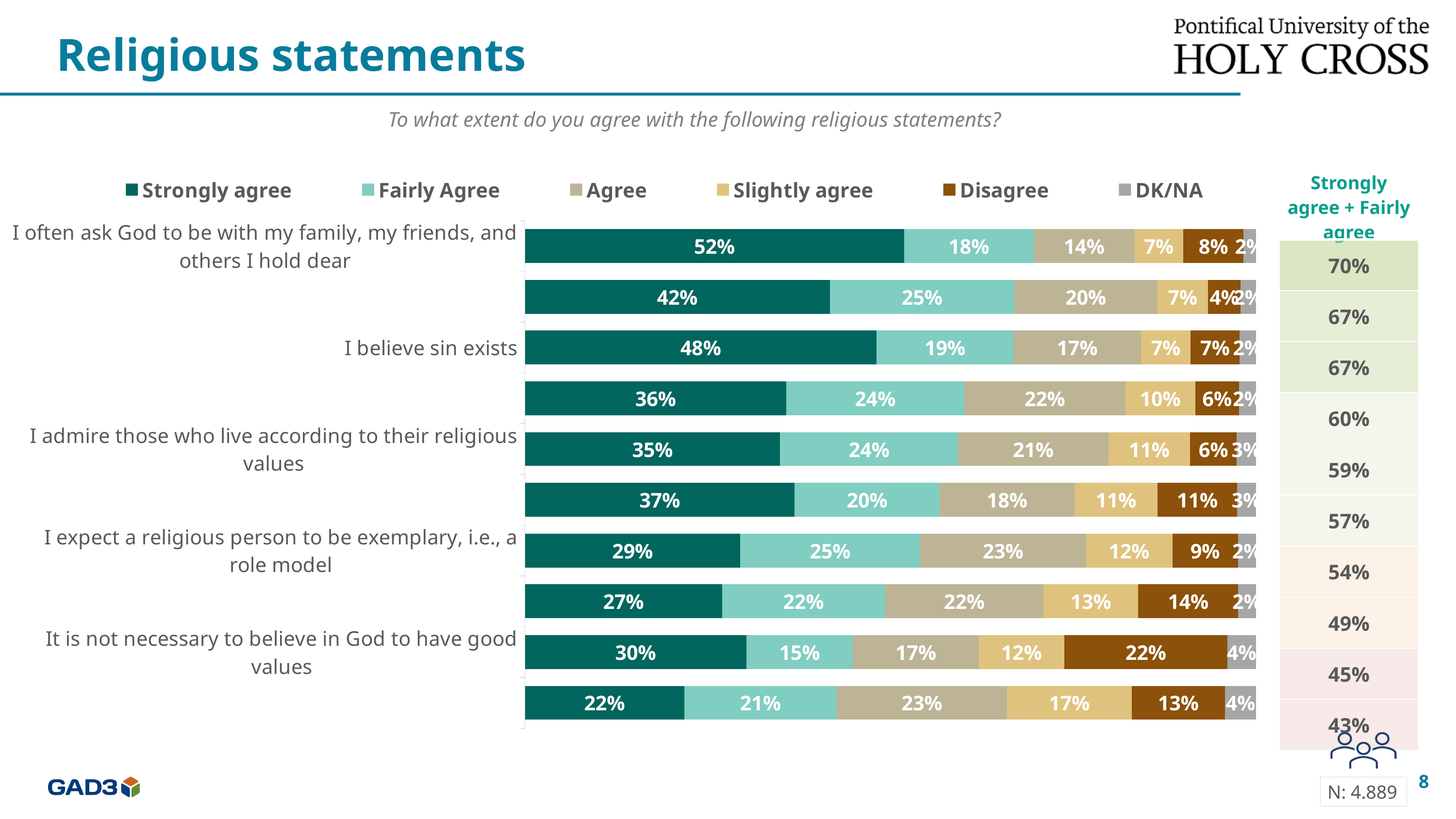
What is the Disagree value for "It is not necessary to believe in God to have good values"? 22% How many bars (statements) are plotted in the chart? 10 How many series does the chart legend list? 6 What kind of chart is shown on the slide? stacked bar chart What is the difference between the Strongly agree values for "I often ask God to be with my family, my friends, and others I hold dear" and "I believe sin exists"? 4% What is the Strongly agree value for "I often ask God to be with my family, my friends, and others I hold dear"? 52% Which statement has the highest Strongly agree value? I often ask God to be with my family, my friends, and others I hold dear What is the first series listed in the chart legend? Strongly agree What is the Slightly agree value for "I admire those who live according to their religious values"? 11% What is the Fairly Agree value for "I believe sin exists"? 19% Which is larger: the Disagree value for "It is not necessary to believe in God to have good values" or the Disagree value for "I believe sin exists"? It is not necessary to believe in God to have good values What is the Agree value for "I expect a religious person to be exemplary, i.e., a role model"? 23%